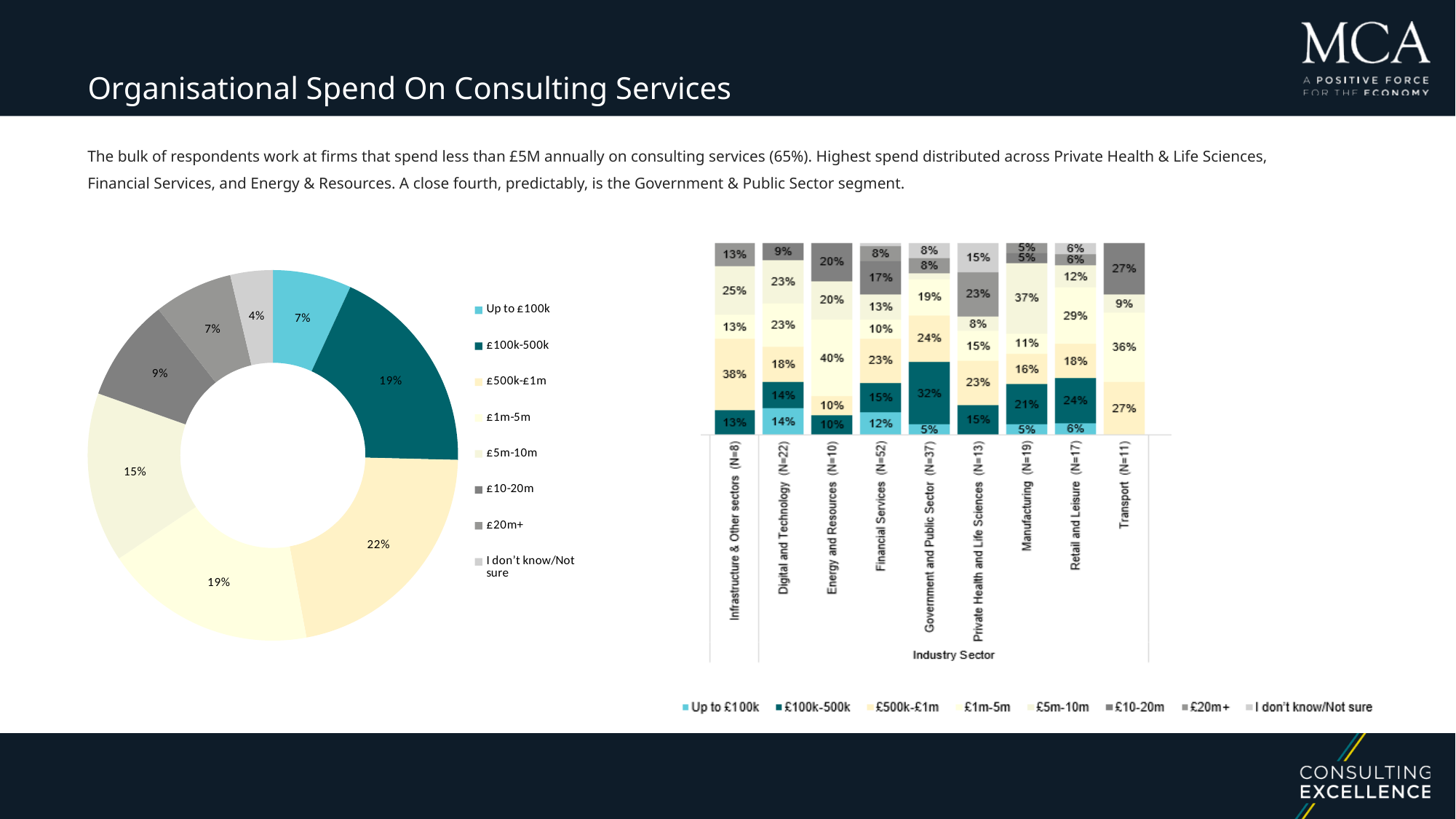
In the stacked bar chart on the right, how many series does the legend list? 8 In the donut chart on the left, what is the difference between the £500k-£1m share and the £5m-10m share? 7% In the stacked bar chart on the right, what is the largest single segment value shown in the Energy and Resources bar? 40% In the donut chart on the left, which is larger: the share for £10-20m or the share for £20m+? £10-20m In the donut chart on the left, what share of respondents work at firms spending £500k-£1m on consulting services? 22% How many categories does the legend of the donut chart on the left list? 8 In the donut chart on the left, which category has the smallest share? I don't know/Not sure What type of chart is shown on the left of the slide? Donut (pie) chart In the donut chart on the left, what percentage is shown for the 'Up to £100k' category? 7% In the stacked bar chart on the right, how many industry sectors are shown on the x axis? 9 In the stacked bar chart on the right, what is the sample size (N) shown for Financial Services? N=52 In the donut chart on the left, which spend category has the largest share? £500k-£1m